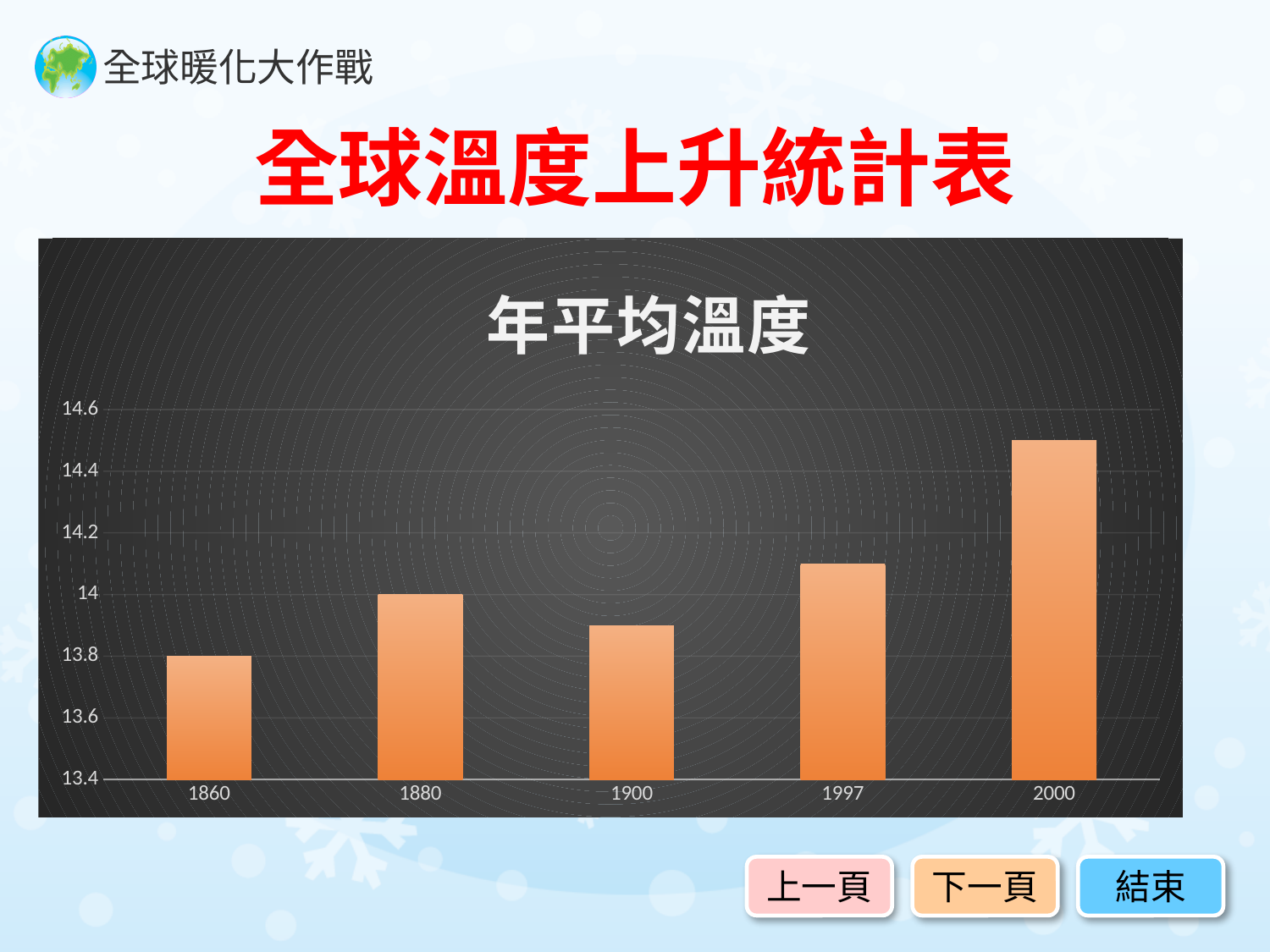
Which is larger, the value for 1997 or the value for 1900? 1997 What kind of chart is shown on the slide? bar chart Which year has the lowest average temperature on the chart? 1860 What is the average temperature value shown for 1880? 14 Is the value for 1900 greater or less than 14? less How many years (categories) are plotted on the chart? 5 What is the difference between the values for 1880 and 1860? 0.2 Is the value for 2000 greater or less than 14.4? greater Is the value for 1997 greater or less than 14? greater What is the average temperature value shown for 1860? 13.8 What is the title of the chart? 年平均溫度 Which year has the highest average temperature on the chart? 2000